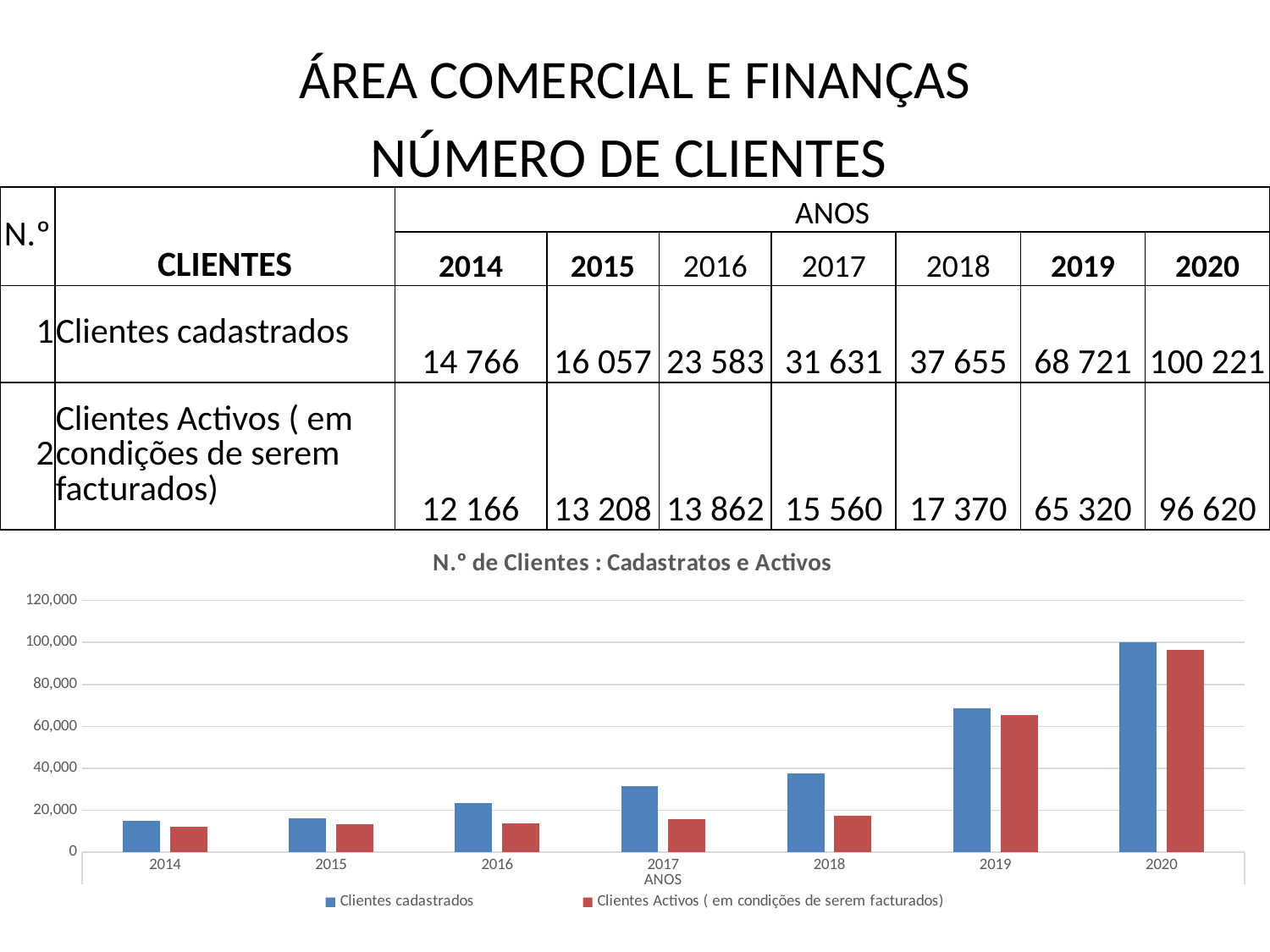
Do the values for Clientes cadastrados rise or fall from 2014 to 2020? rise How many series does the chart legend list? 2 How many years are shown on the x axis of the chart? 7 Which year has the lowest value for Clientes Activos? 2014 Is the value for Clientes cadastrados in 2019 greater or less than 60,000? greater Which year has the highest value for Clientes cadastrados? 2020 What is the value of Clientes Activos in 2019? 65 320 What is the title of the chart? N.º de Clientes : Cadastratos e Activos Which is larger in 2017: Clientes cadastrados or Clientes Activos? Clientes cadastrados What type of chart is shown on the slide? bar chart What is the value of Clientes cadastrados in 2020? 100 221 What is the difference between Clientes cadastrados and Clientes Activos in 2018? 20 285